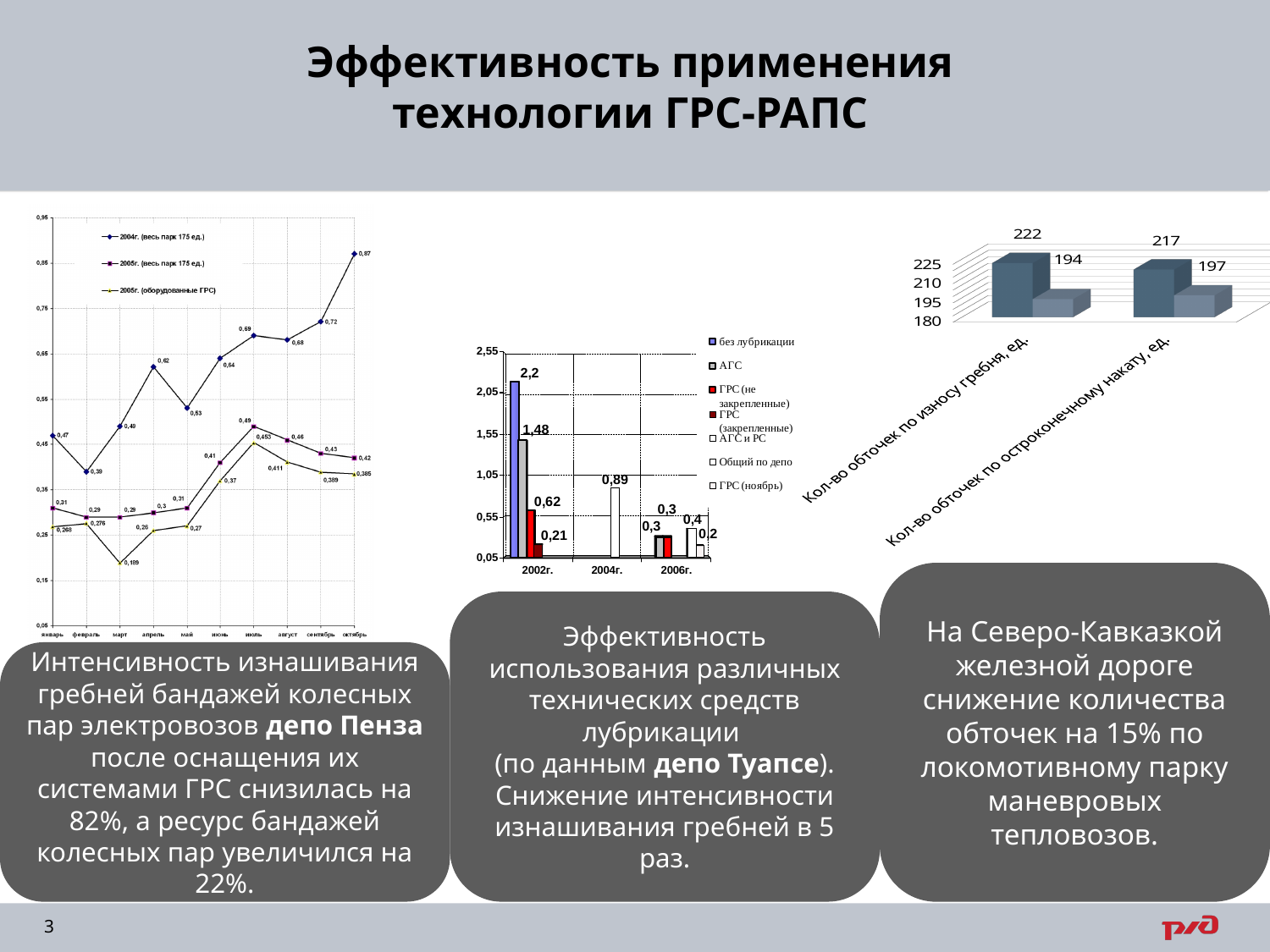
In the middle bar chart, what is the value of the tallest bar for 2002г.? 2,2 In the left line chart, in which month does the 2004 series (весь парк 175 ед.) reach its highest value? октябрь In the left line chart, what is the value for the 2004 series (весь парк 175 ед.) in октябрь? 0,87 In the left line chart, how many series does the legend list? 3 In the middle bar chart, how many entries does the legend list? 7 In the middle bar chart, what is the value of the bar shown for 2004г.? 0,89 In the right 3D bar chart, what is the difference between the two values for Кол-во обточек по остроконечному накату, ед.? 20 In the left line chart, what is the difference between the 2004 series and the 2005 весь парк series in октябрь? 0,45 In the left line chart, does the 2004 series (весь парк 175 ед.) generally rise or fall from январь to октябрь? rise In the left line chart, what is the value for the 2005 series оборудованные ГРС in март? 0,189 In the right 3D bar chart, what is the larger value for Кол-во обточек по износу гребня, ед.? 222 In the middle bar chart, what is the difference between the 2,2 bar and the 1,48 bar for 2002г.? 0,72